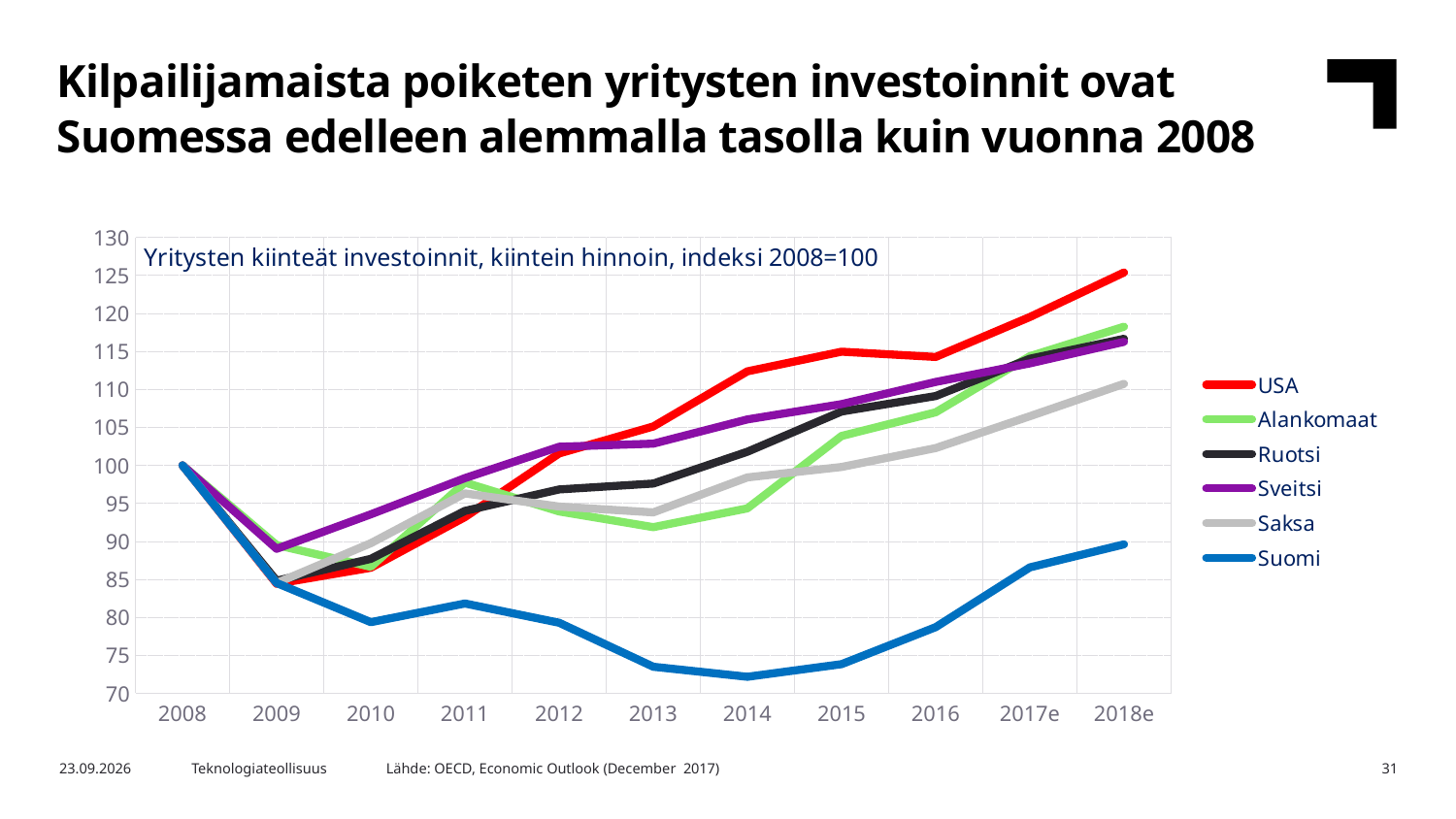
How many series does the legend list? 6 What kind of chart is shown on the slide? line chart Which country has the highest index value in 2018e? USA Is the value for USA in 2018e greater or less than 120? greater How many years are shown on the x axis? 11 Is the value for Suomi in 2014 greater or less than 75? less Which country has the lowest index value in 2018e? Suomi Is the value for Alankomaat in 2013 greater or less than 95? less What colour is the line for Suomi? blue Which is larger in 2018e, the value for USA or the value for Suomi? USA What is the index value for Suomi in 2008? 100 Does the value for Suomi rise or fall from 2014 to 2018e? rise